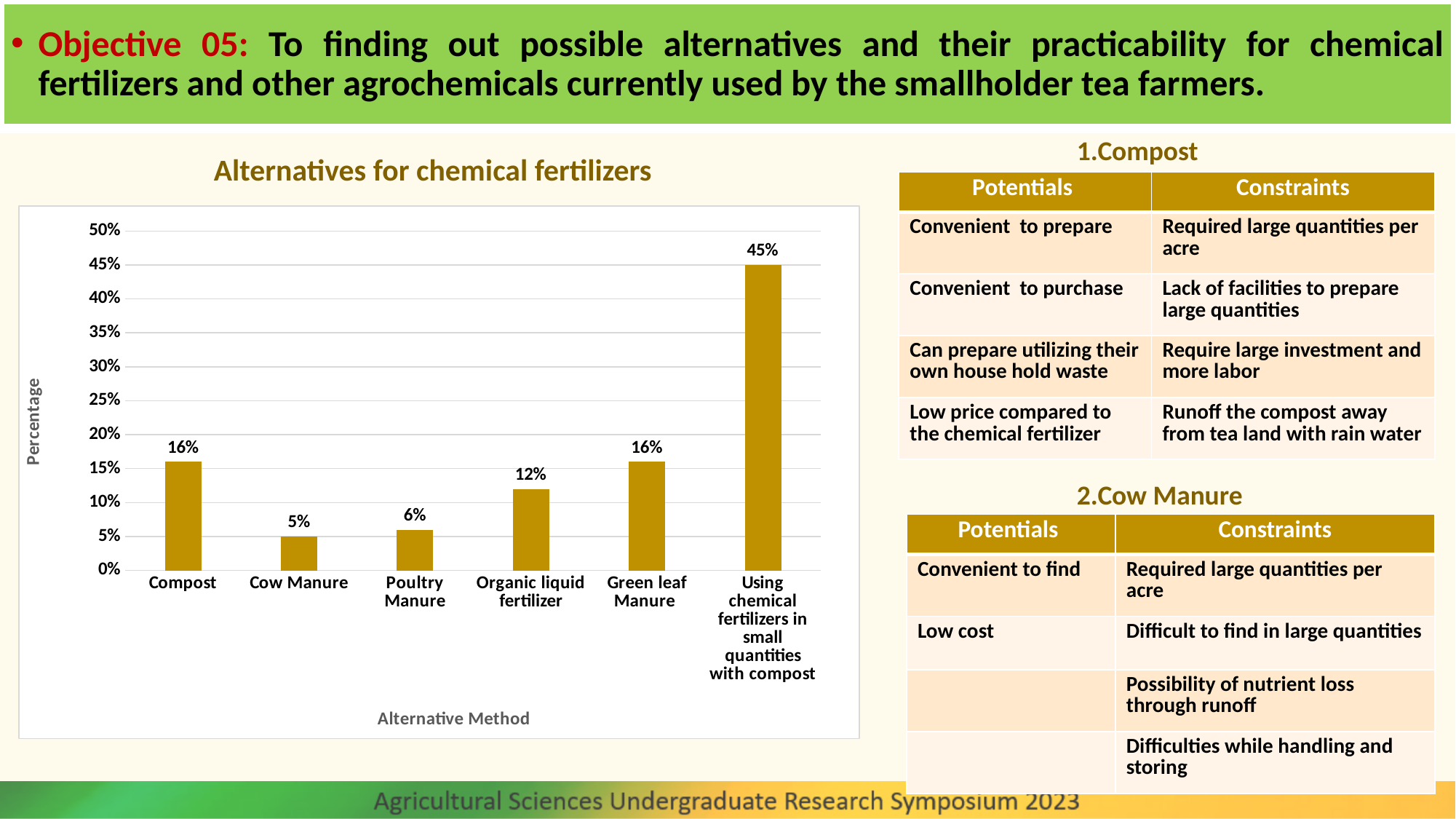
What is the title of the chart? Alternatives for chemical fertilizers Which alternative method has the highest percentage? Using chemical fertilizers in small quantities with compost What is the difference between the value for Using chemical fertilizers in small quantities with compost and the value for Green leaf Manure? 29% What is the label of the x axis of the chart? Alternative Method What is the value for Organic liquid fertilizer in the chart? 12% What kind of chart is shown on the slide? Bar chart How many alternative methods are shown in the chart? 6 What is the value for Poultry Manure in the chart? 6% What is the value for Compost in the chart? 16% Which alternative method has the lowest percentage? Cow Manure What is the value for Cow Manure in the chart? 5% Which is larger, the value for Organic liquid fertilizer or the value for Poultry Manure? Organic liquid fertilizer